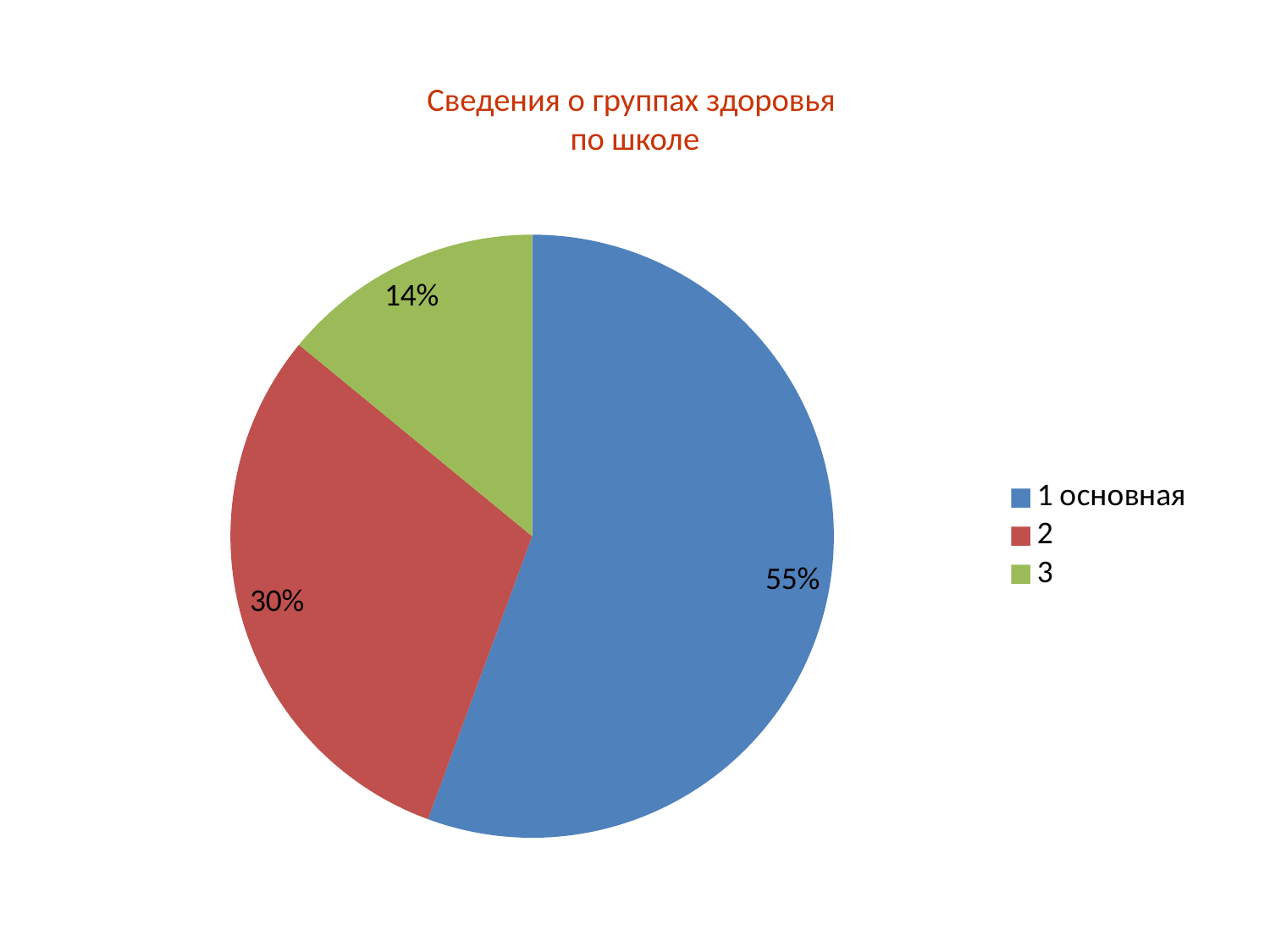
What is the difference in percentage points between the "2" slice and the "3" slice? 16 What colour is the "1 основная" slice? blue What kind of chart is shown on the slide? pie chart What share of the pie does the "3" slice have? 14% What share of the pie does the "1 основная" slice have? 55% Which category has the smallest slice of the pie? 3 What is the title of the chart? Сведения о группах здоровья по школе How many slices does the pie chart have? 3 What share of the pie does the "2" slice have? 30% Which is larger, the "2" slice or the "3" slice? 2 What is the difference in percentage points between the "1 основная" slice and the "2" slice? 25 Which category has the largest slice of the pie? 1 основная